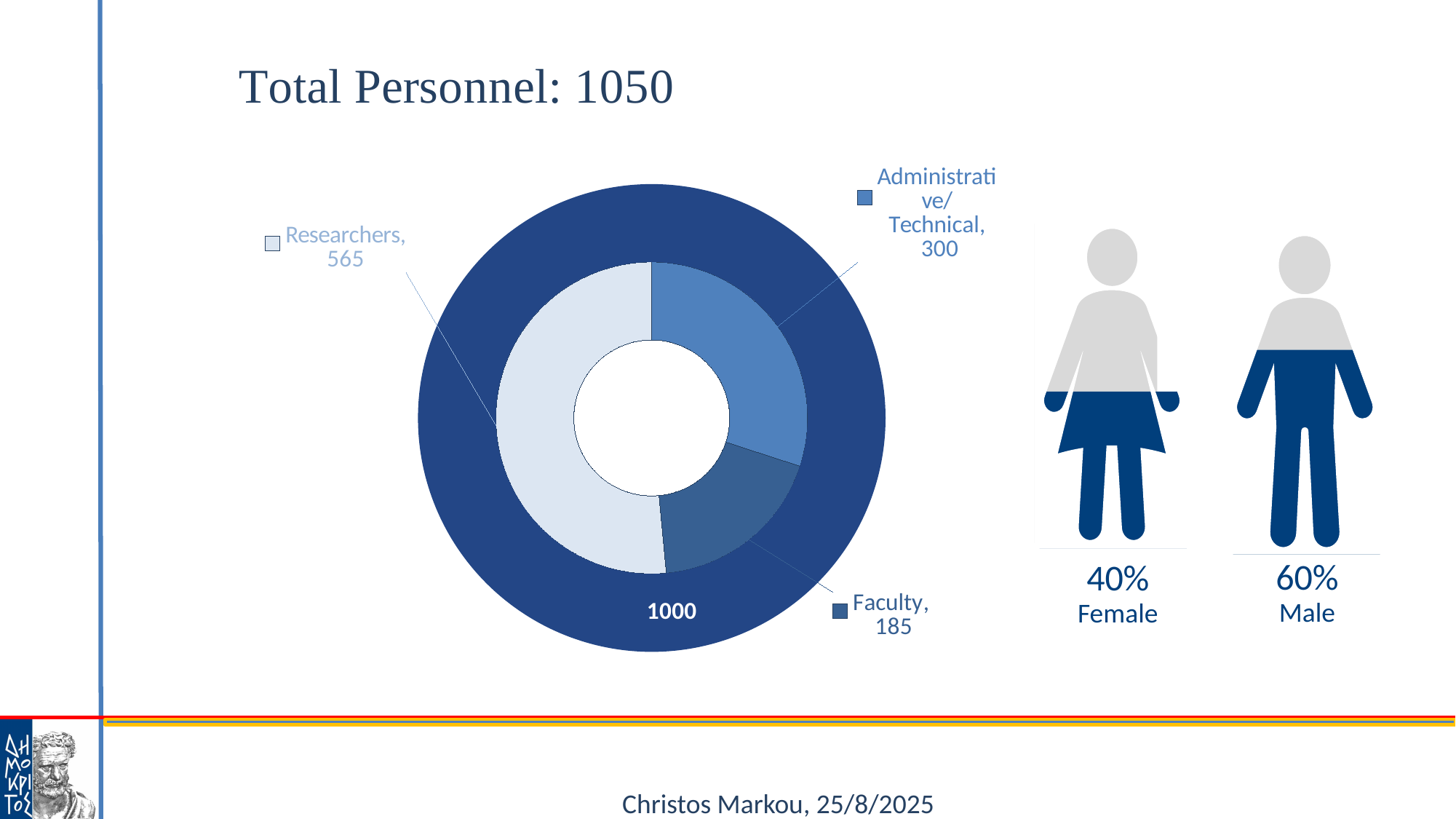
What is the difference between the Researchers value and the Faculty value? 380 What is the value for Researchers in the doughnut chart? 565 What is the value for Faculty in the doughnut chart? 185 What is the title shown above the chart? Total Personnel: 1050 Which category has the lowest value in the doughnut chart? Faculty Which category has the highest value in the doughnut chart? Researchers What is the difference between the Administrative/Technical value and the Faculty value? 115 What kind of chart is shown on the slide? Doughnut chart What is the difference between the Researchers value and the Administrative/Technical value? 265 What is the value for Administrative/Technical in the doughnut chart? 300 Which is larger, the value for Administrative/Technical or the value for Faculty? Administrative/Technical How many categories are shown in the doughnut chart? 3